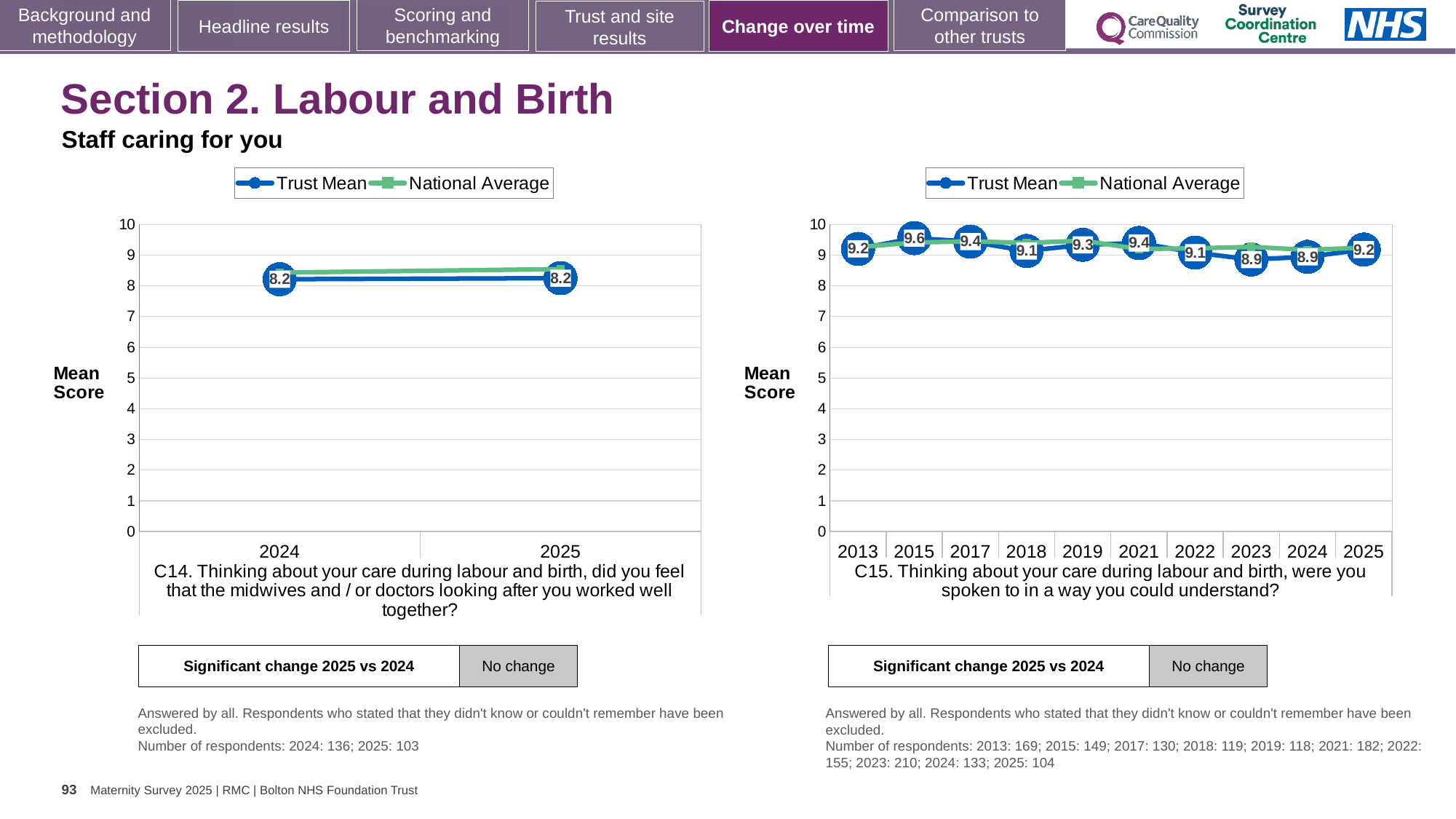
In the right chart (C15), which is larger, the Trust Mean score for 2019 or for 2022? 2019 In the left chart (C14), what is the Trust Mean score for 2024? 8.2 In the right chart (C15), how many years are plotted on the x axis? 10 In the left chart (C14), what is the Trust Mean score for 2025? 8.2 In the right chart (C15), which year has the highest Trust Mean score? 2015 In the left chart (C14), is the National Average value for 2025 greater or less than 8? greater In the right chart (C15), what is the difference between the Trust Mean scores for 2015 and 2024? 0.7 In the left chart (C14), how many series does the legend list? 2 In the right chart (C15), does the Trust Mean rise or fall from 2024 to 2025? rise In the right chart (C15), what is the Trust Mean score for 2023? 8.9 In the right chart (C15), what is the Trust Mean score for 2015? 9.6 What kind of chart is the right chart (C15)? Line chart